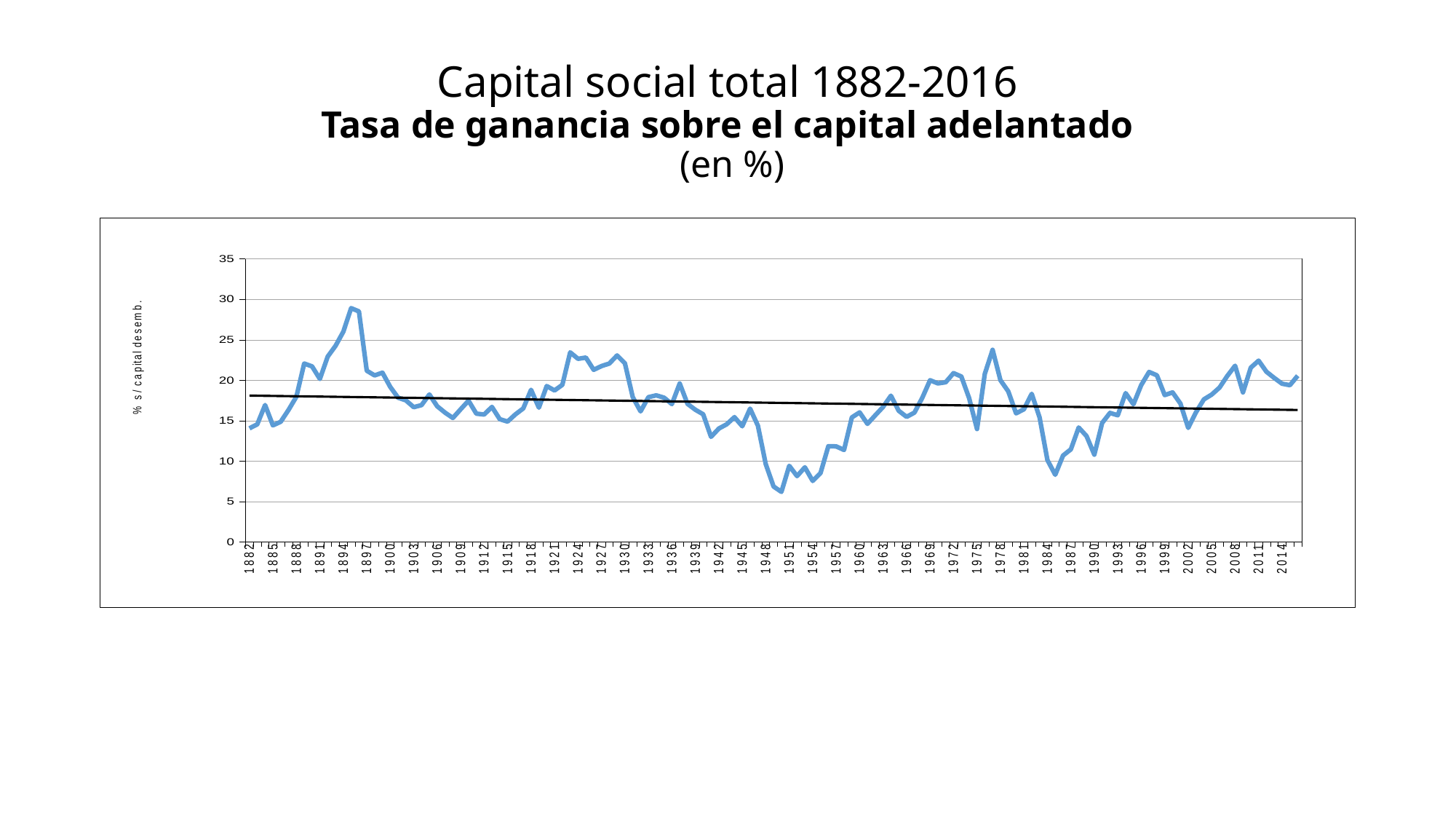
What is the highest tick value shown on the y axis? 35 In which decade does the blue line reach its lowest value? 1950s What is the label on the y axis? % s/ capital desemb. What kind of chart is shown on the slide? line chart In which decade does the blue line reach its highest value? 1890s Is the value for 1950 greater or less than 10? less Is the value for 1895 greater or less than 25? greater Which year has the higher value, 1895 or 1950? 1895 Is the value for 1977 greater or less than 20? greater Does the straight black trend line rise or fall from 1882 to 2016? fall